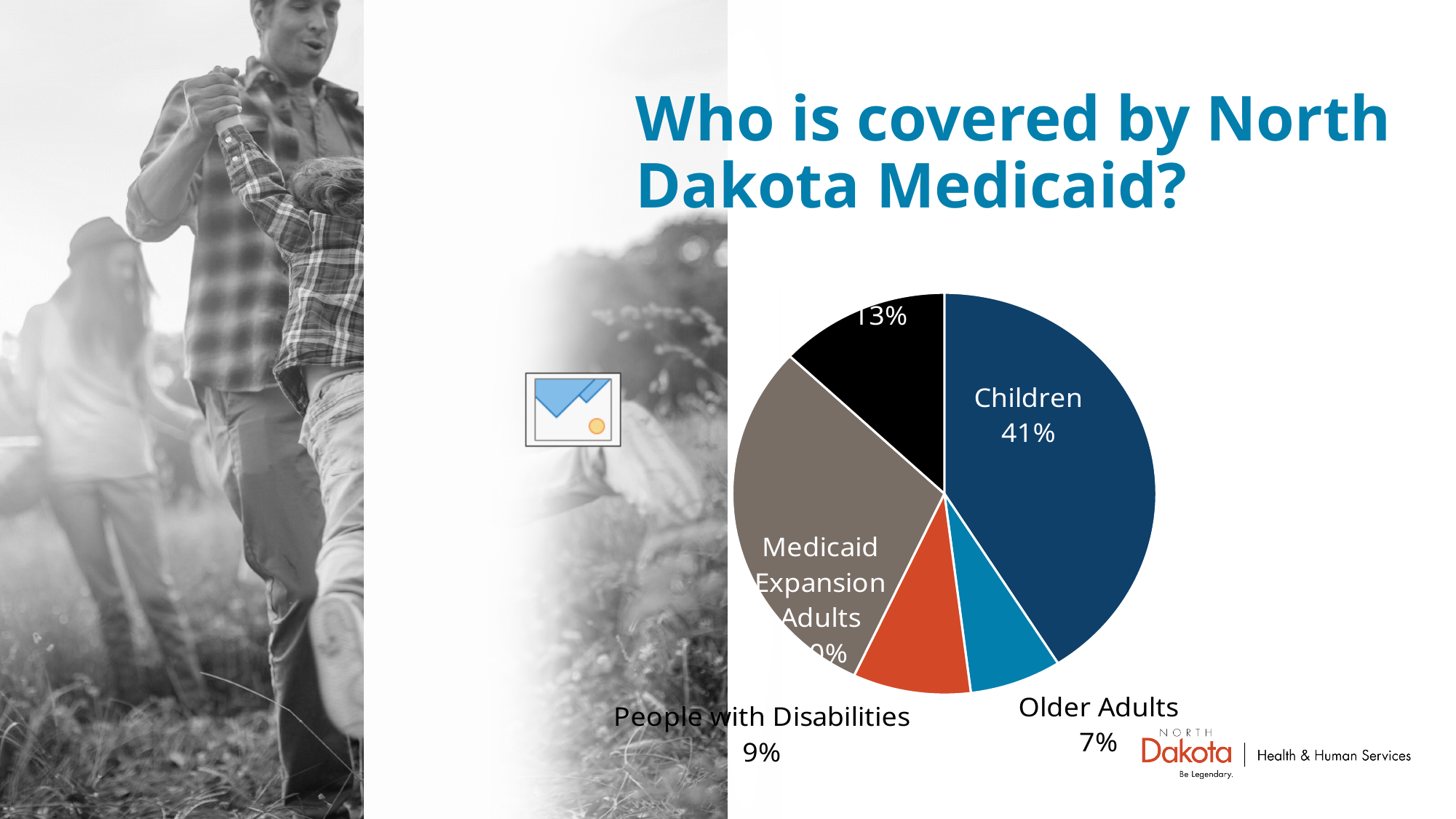
What is the title of the chart on the slide? Who is covered by North Dakota Medicaid? How many percentage points larger is the Children share than the Older Adults share? 34 What percentage of North Dakota Medicaid coverage is Children? 41% Which category has the largest share of the pie? Children Which labelled category has the smallest share of the pie? Older Adults Which is larger, the share for Children or the share for Older Adults? Children Which is larger, the share for People with Disabilities or the share for Older Adults? People with Disabilities What colour is the Children slice of the pie? dark blue What percentage of the pie is People with Disabilities? 9% How many slices does the pie chart have? 5 What kind of chart is shown on the slide? pie chart What percentage of the pie is Older Adults? 7%